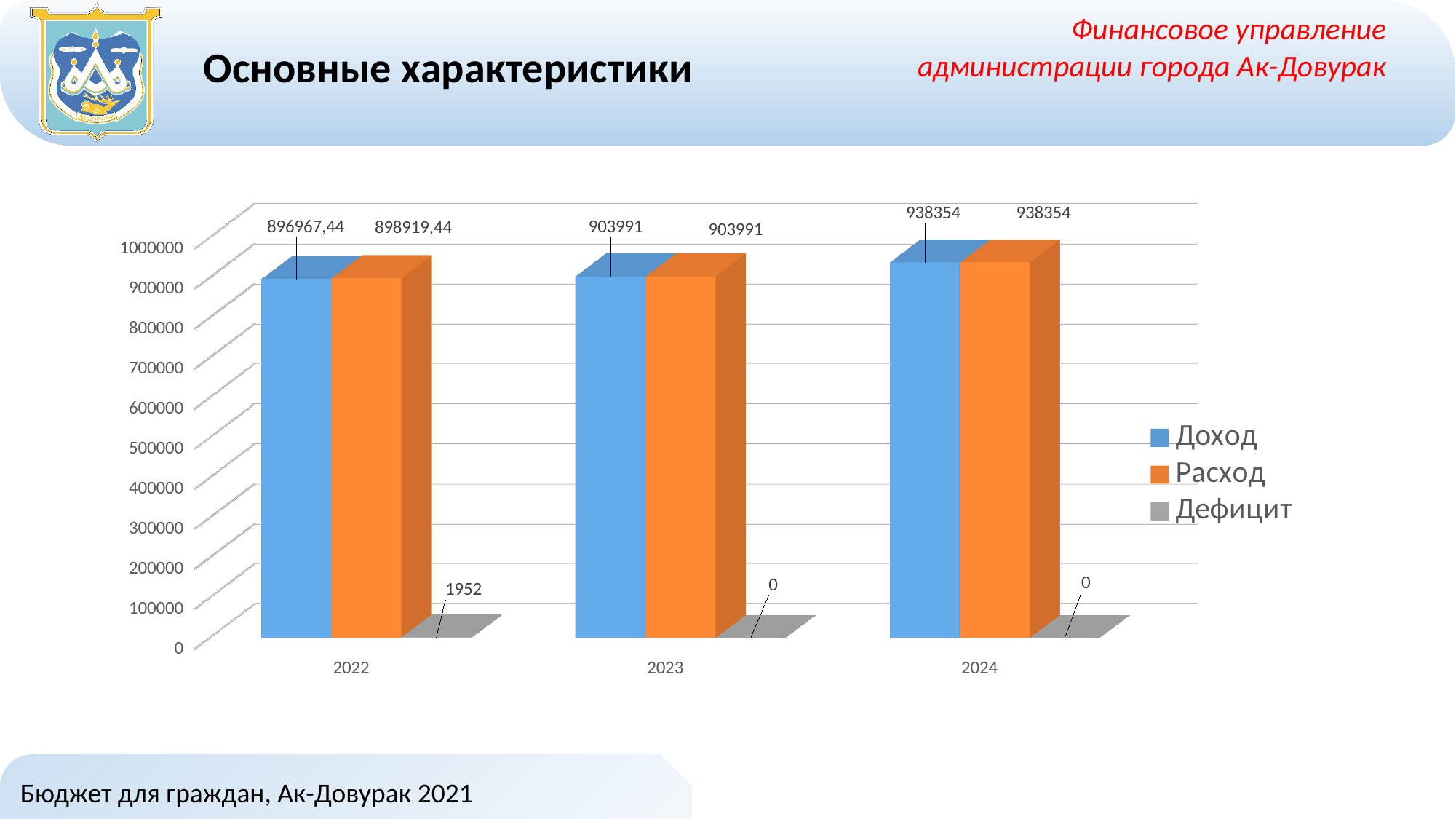
Is the value of Доход for 2023 greater or less than 900000? greater What is the value of Дефицит for 2022? 1952 What is the value of Дефицит for 2023? 0 What kind of chart is shown on the slide? Bar chart What is the value of Доход for 2024? 938354 What is the difference between Расход and Доход in 2022? 1952 In which year is Доход the highest? 2024 Which is larger in 2022, Доход or Расход? Расход How many series does the legend list? 3 What is the value of Расход for 2022? 898919,44 In which year is Расход the lowest? 2022 What is the value of Доход for 2022? 896967,44